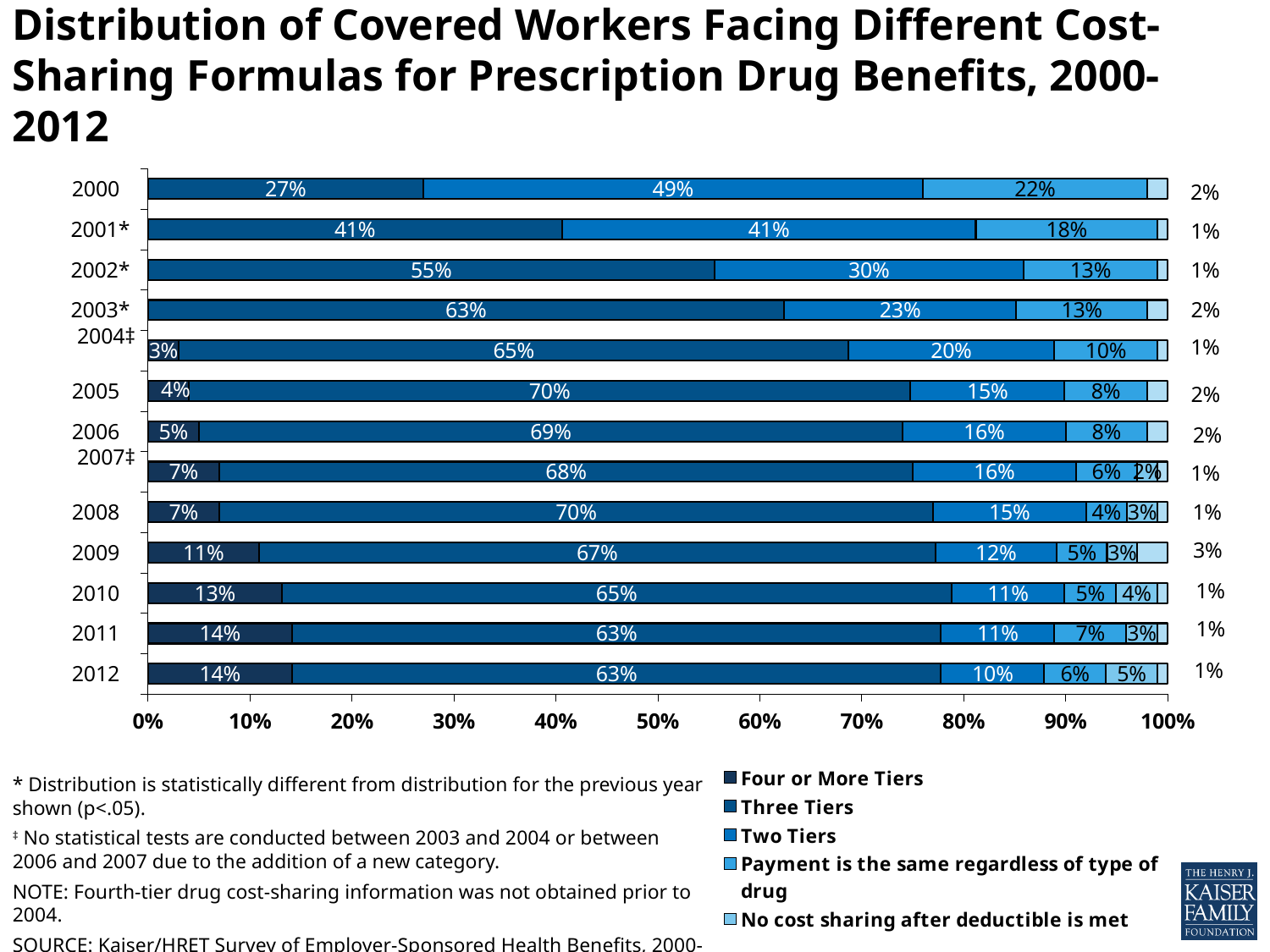
In which year was the Two Tiers share the highest? 2000 By how many percentage points did the Three Tiers share in 2012 exceed the Three Tiers share in 2000? 36 percentage points What percentage of covered workers in 2004 had payment that is the same regardless of type of drug? 10% Does the Four or More Tiers share rise or fall from 2004 to 2012? Rise In which year was the Three Tiers share the lowest? 2000 What percentage of covered workers faced Two Tiers in 2000? 49% How many series does the legend list? 5 What percentage of covered workers faced Three Tiers in 2000? 27% How many years are plotted on the chart? 13 In 2002, which was larger: the Three Tiers share or the Two Tiers share? Three Tiers What percentage of covered workers faced Four or More Tiers in 2012? 14% What kind of chart is shown on the slide? Stacked bar chart